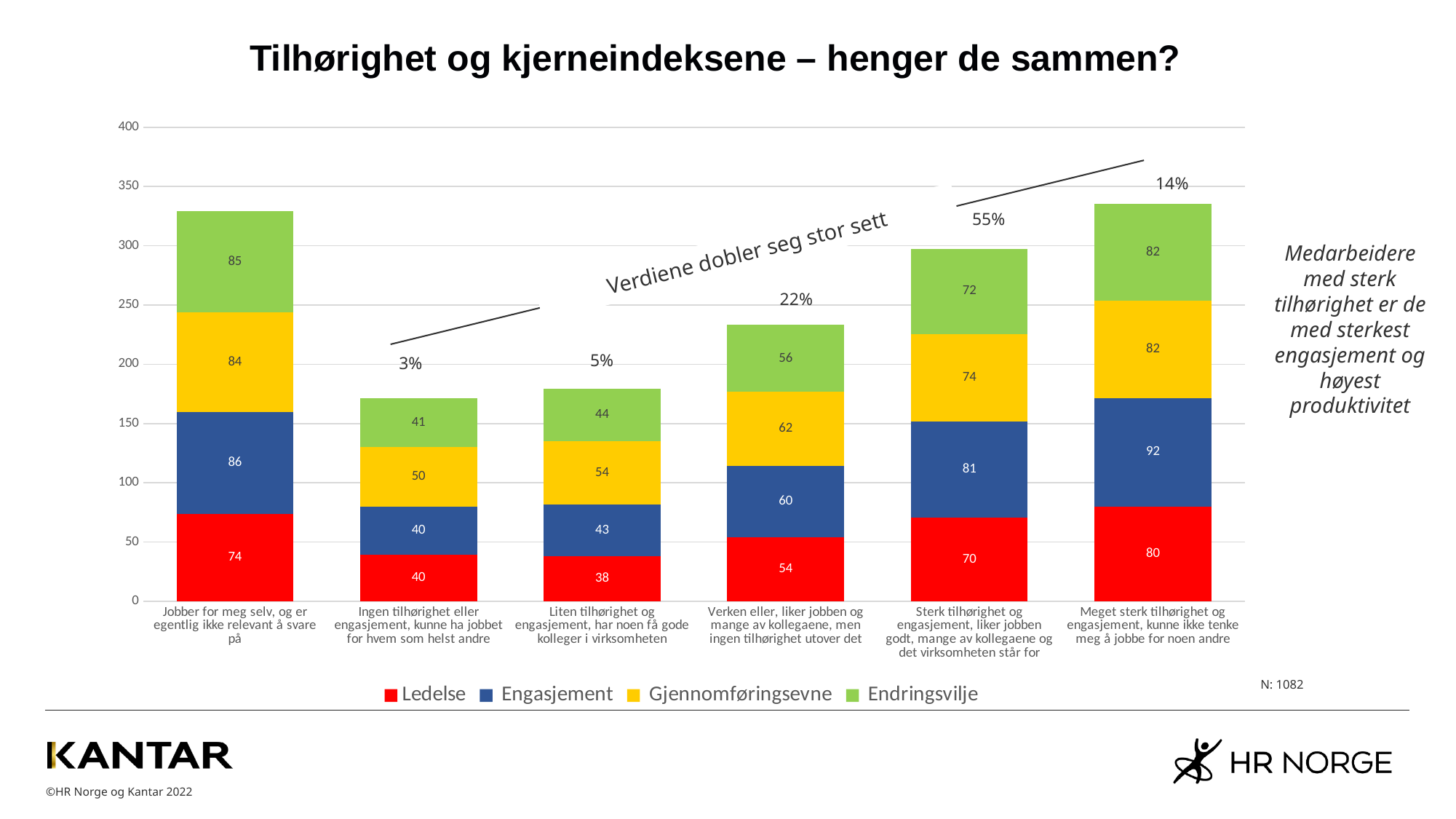
Which category has the highest Engasjement value? Meget sterk tilhørighet og engasjement, kunne ikke tenke meg å jobbe for noen andre How many categories are shown on the x axis? 6 What is the total of the stacked bar for 'Ingen tilhørighet eller engasjement, kunne ha jobbet for hvem som helst andre'? 171 What is the Ledelse value for the category 'Meget sterk tilhørighet og engasjement, kunne ikke tenke meg å jobbe for noen andre'? 80 What is the Engasjement value for the category 'Ingen tilhørighet eller engasjement, kunne ha jobbet for hvem som helst andre'? 40 What is the difference between the Gjennomføringsevne values for 'Sterk tilhørighet og engasjement, liker jobben godt, mange av kollegaene og det virksomheten står for' and 'Liten tilhørighet og engasjement, har noen få gode kolleger i virksomheten'? 20 How many series does the legend list? 4 What is the Endringsvilje value for the category 'Verken eller, liker jobben og mange av kollegaene, men ingen tilhørighet utover det'? 56 Is the total of the stacked bar for 'Verken eller, liker jobben og mange av kollegaene, men ingen tilhørighet utover det' greater or less than 250? less Which colour represents Gjennomføringsevne in the legend? Yellow What kind of chart is shown on the slide? Stacked bar chart Which category has the lowest Ledelse value? Liten tilhørighet og engasjement, har noen få gode kolleger i virksomheten